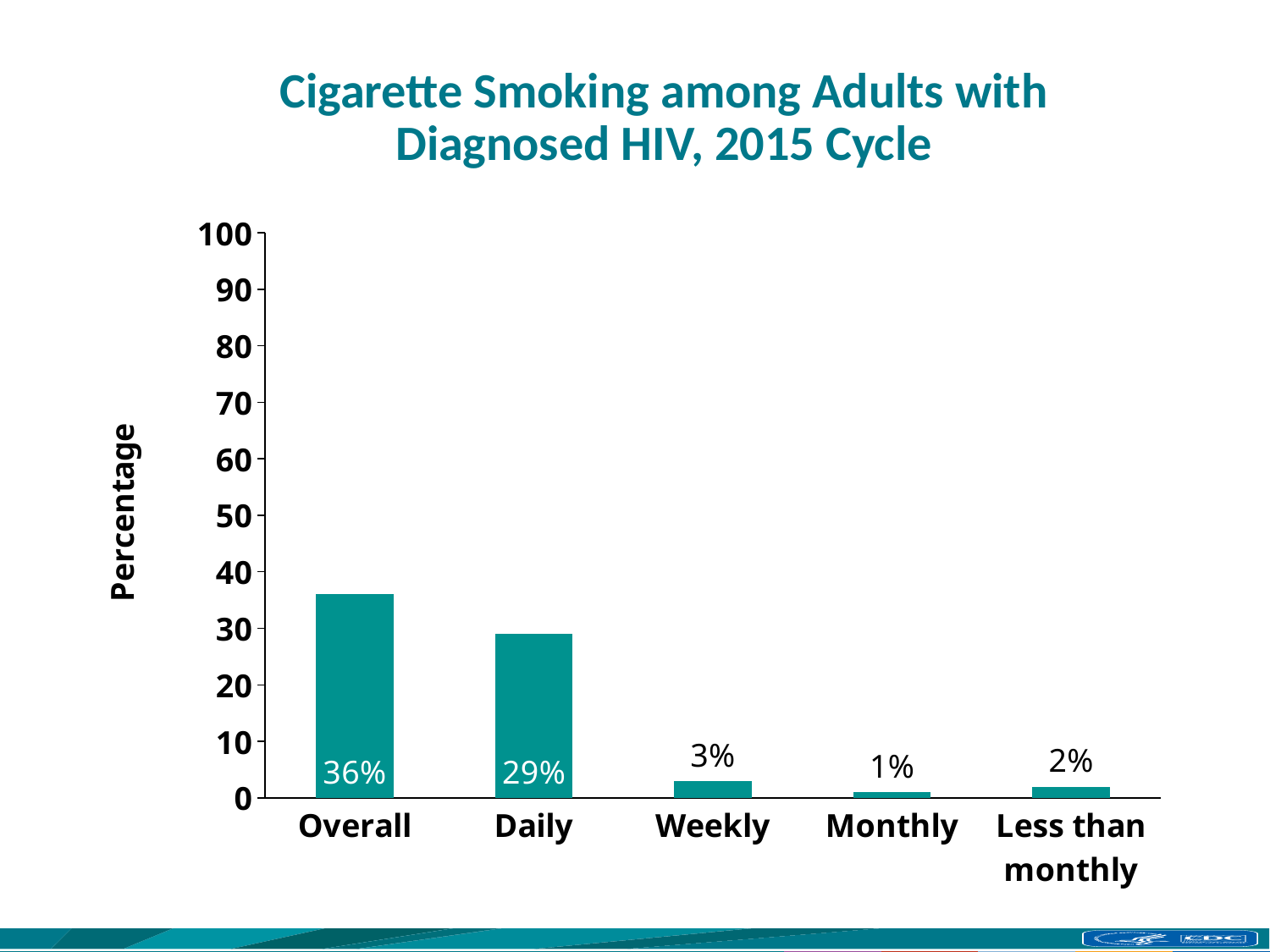
What is the value for Weekly? 3% What is the difference between the Overall and Daily values? 7% Which category has the highest value? Overall Which is larger, the value for Weekly or the value for Monthly? Weekly Is the value for Overall greater or less than 40? less What is the value for Overall? 36% How many categories are shown on the x axis? 5 What is the value for Less than monthly? 2% What is the value for Daily? 29% What is the label of the y axis? Percentage Which category has the lowest value? Monthly What kind of chart is shown on the slide? bar chart